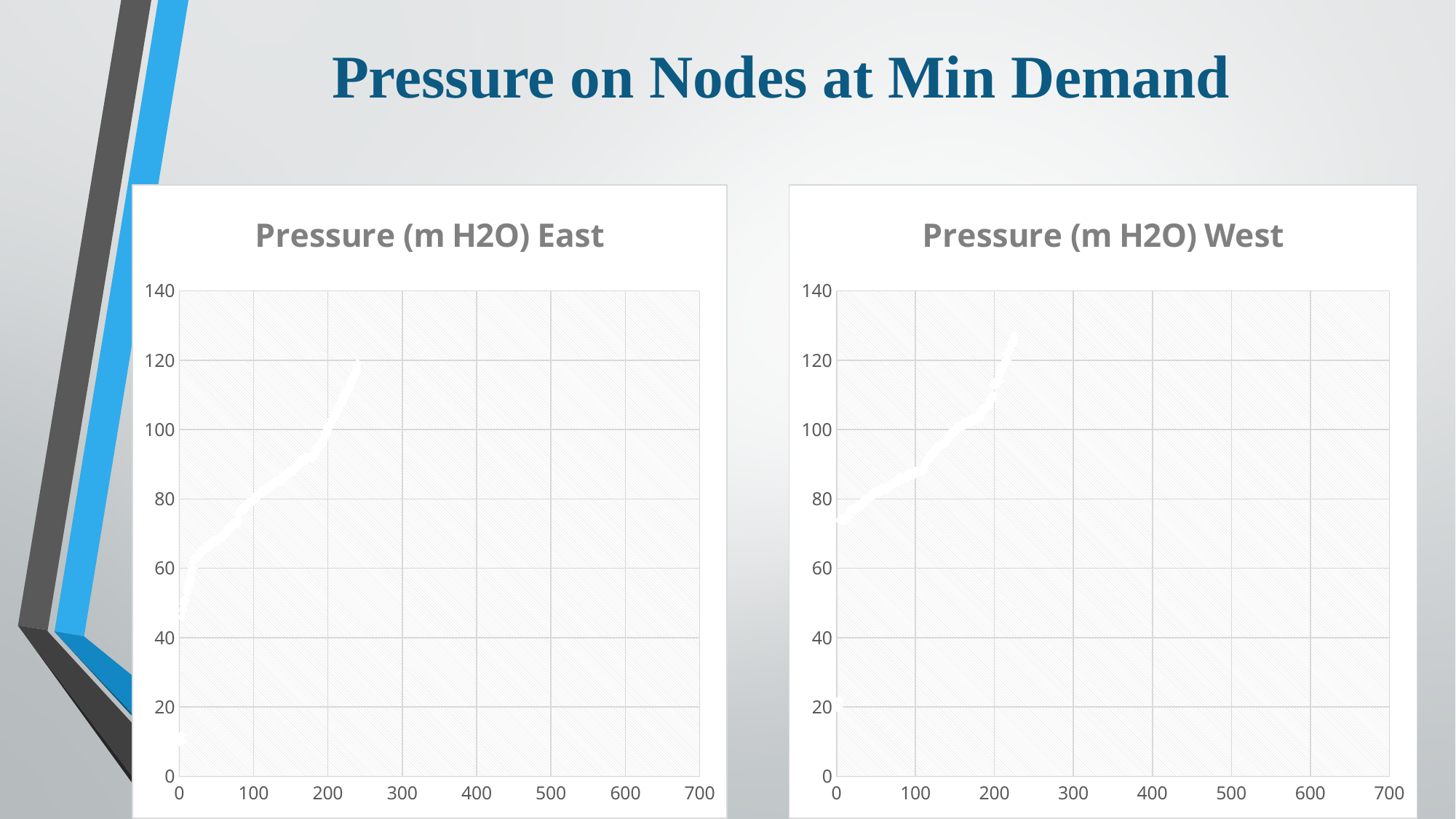
In the 'Pressure (m H2O) East' chart, is the lowest plotted value greater or less than 20? less What kind of chart is the 'Pressure (m H2O) East' chart? line chart In the 'Pressure (m H2O) East' chart, do the values rise or fall as you move along the x axis? rise In the 'Pressure (m H2O) West' chart, is the highest plotted value greater or less than 120? greater In the 'Pressure (m H2O) West' chart, is the value at x = 100 greater or less than 80? greater What kind of chart is the 'Pressure (m H2O) West' chart? line chart What is the maximum value shown on the y axis of the 'Pressure (m H2O) West' chart? 140 In the 'Pressure (m H2O) West' chart, do the values rise or fall as you move along the x axis? rise What is the title of the chart on the left side of the slide? Pressure (m H2O) East